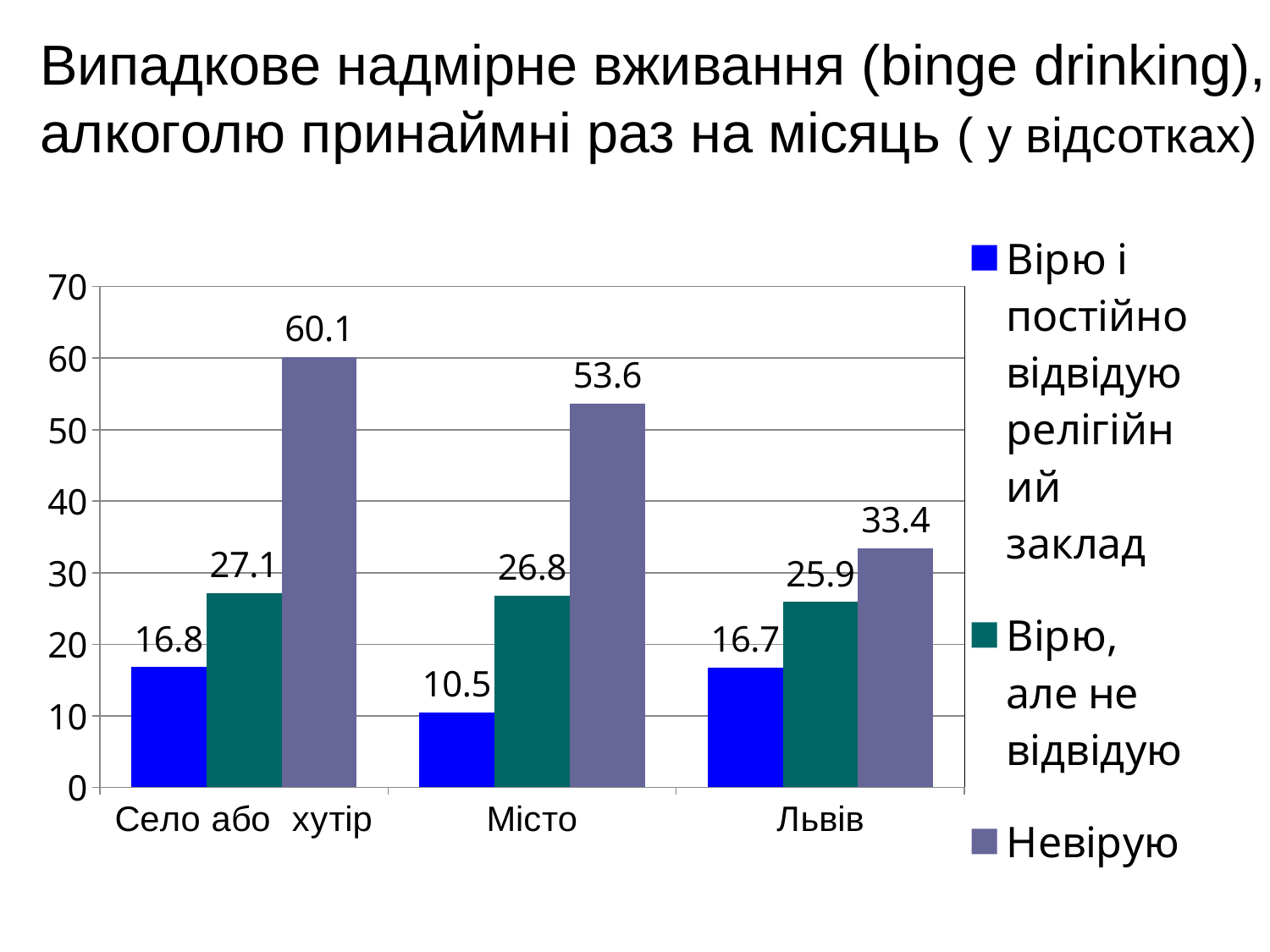
Which colour represents the "Невірую" series? purple-grey What is the difference between the "Невірую" value and the "Вірю, але не відвідую" value in the "Місто" category? 26.8 Which category has the lowest value for the "Вірю і постійно відвідую релігійний заклад" series? Місто How many categories are shown on the x axis? 3 What is the value for "Вірю і постійно відвідую релігійний заклад" in the "Місто" category? 10.5 What is the value for "Невірую" in the "Село або хутір" category? 60.1 How many series does the legend list? 3 Which category has the highest value for the "Невірую" series? Село або хутір What is the value for "Вірю, але не відвідую" in the "Львів" category? 25.9 Which is larger in the "Львів" category: the value for "Невірую" or the value for "Вірю, але не відвідую"? Невірую What kind of chart is shown on the slide? bar chart Is the value for "Невірую" in the "Львів" category greater or less than 40? less